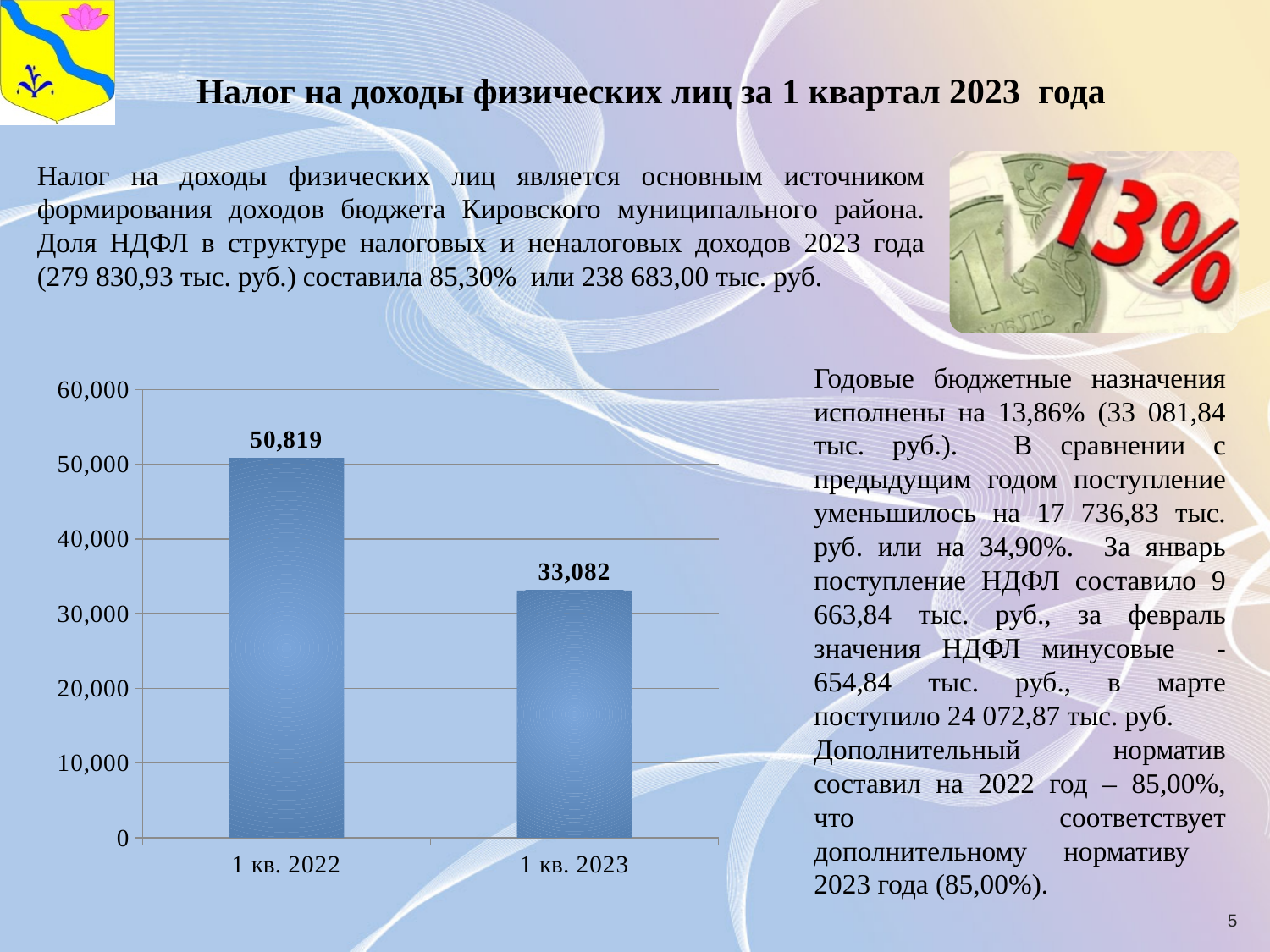
What is the highest tick value shown on the vertical axis? 60,000 Is the value for 1 кв. 2023 greater or less than 40,000? less What is the value for 1 кв. 2023? 33,082 Which is larger, the value for 1 кв. 2022 or the value for 1 кв. 2023? 1 кв. 2022 What is the difference between the values for 1 кв. 2022 and 1 кв. 2023? 17,737 Do the values rise or fall from 1 кв. 2022 to 1 кв. 2023? fall Which category has the highest value? 1 кв. 2022 Which category has the lowest value? 1 кв. 2023 What is the value for 1 кв. 2022? 50,819 How many categories are shown on the x axis? 2 What kind of chart is shown on the slide? bar chart Is the value for 1 кв. 2022 greater or less than 50,000? greater